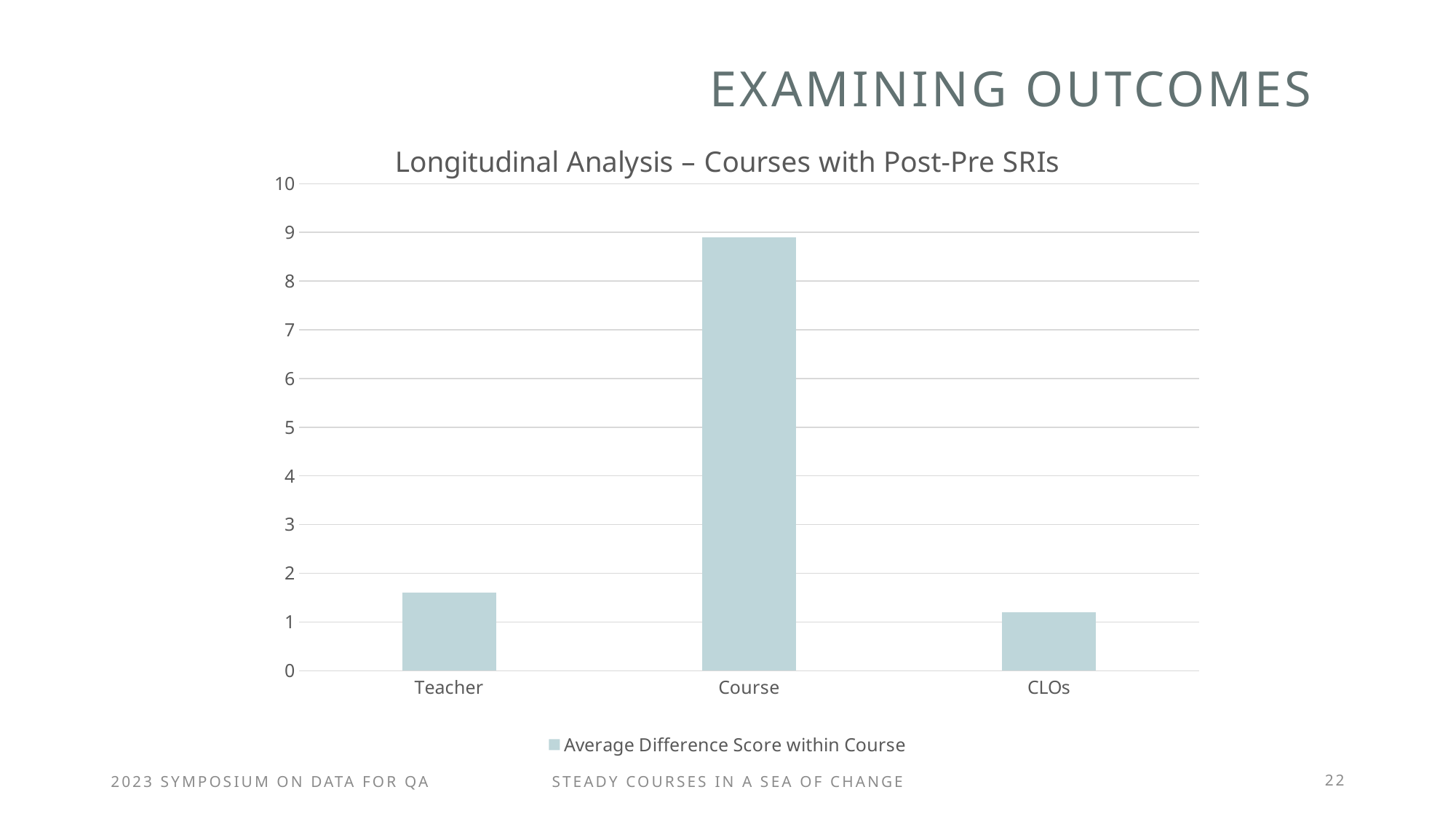
Is the value for Course greater or less than 8? greater Is the value for Teacher greater or less than 2? less What series name is shown in the chart legend? Average Difference Score within Course Which is larger, the value for Teacher or the value for Course? Course How many categories are shown on the x axis of the chart? 3 Is the value for CLOs greater or less than 1? greater Which category has the highest Average Difference Score within Course? Course What kind of chart is shown on the slide? bar chart Which is larger, the value for Teacher or the value for CLOs? Teacher What is the title of the chart? Longitudinal Analysis – Courses with Post-Pre SRIs How many series does the chart legend list? 1 Which category has the lowest Average Difference Score within Course? CLOs